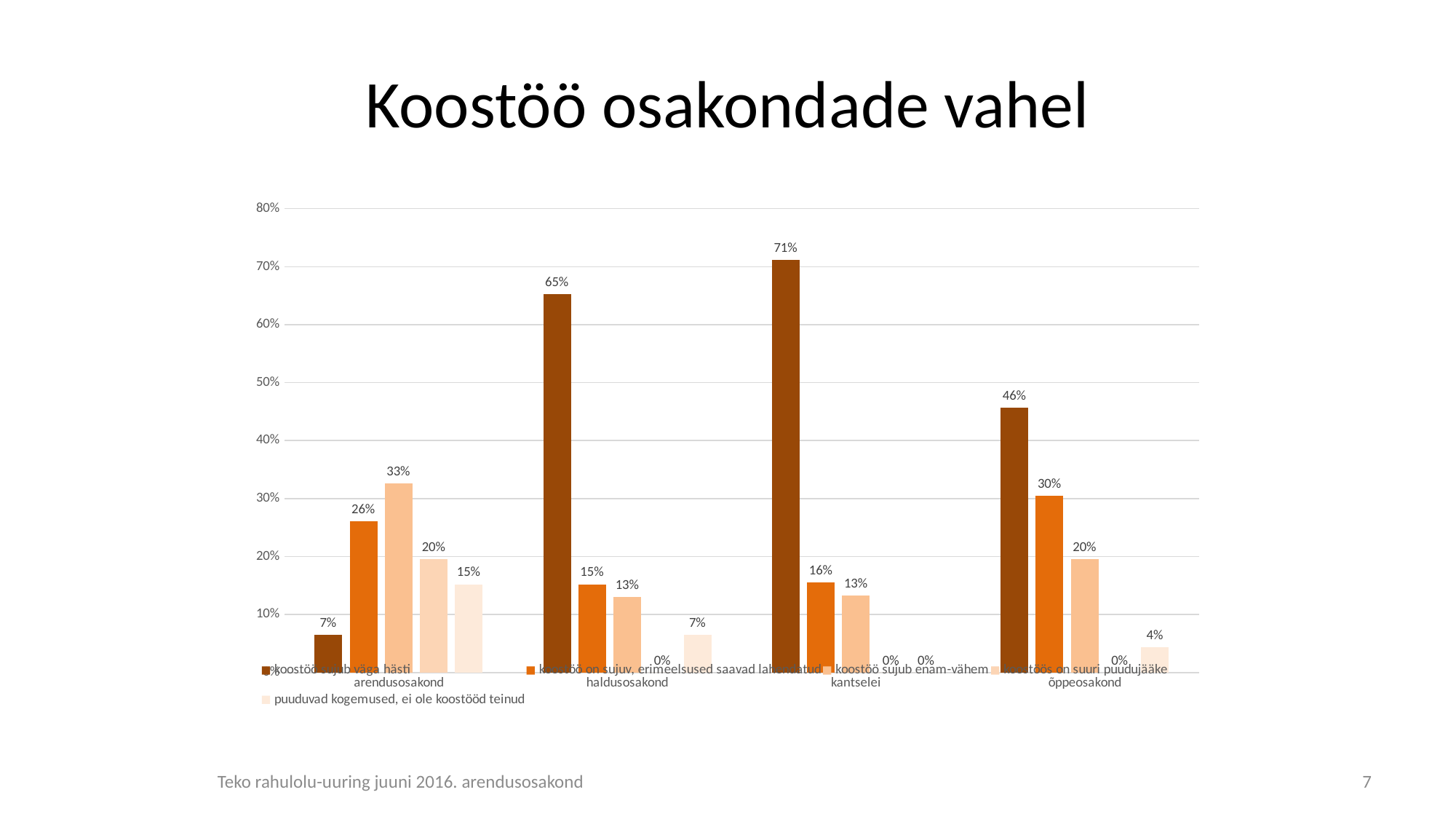
How many categories (departments) are shown on the x axis? 4 What type of chart is shown on the slide? bar chart Which department has the highest value for "koostöö sujub väga hästi"? kantselei What is the value of "koostöö sujub väga hästi" for kantselei? 71% What is the difference between the "koostöö sujub väga hästi" values for kantselei and haldusosakond? 6% What is the title of the chart? Koostöö osakondade vahel What is the value of "puuduvad kogemused, ei ole koostööd teinud" for haldusosakond? 7% Which is larger for arendusosakond: "koostöö sujub enam-vähem" or "koostöö on sujuv, erimeelsused saavad lahendatud"? koostöö sujub enam-vähem What is the value of "koostöö on sujuv, erimeelsused saavad lahendatud" for õppeosakond? 30% How many series does the legend list? 5 What is the value of "koostöö sujub väga hästi" for arendusosakond? 7% Which department has the lowest value for "koostöö sujub väga hästi"? arendusosakond